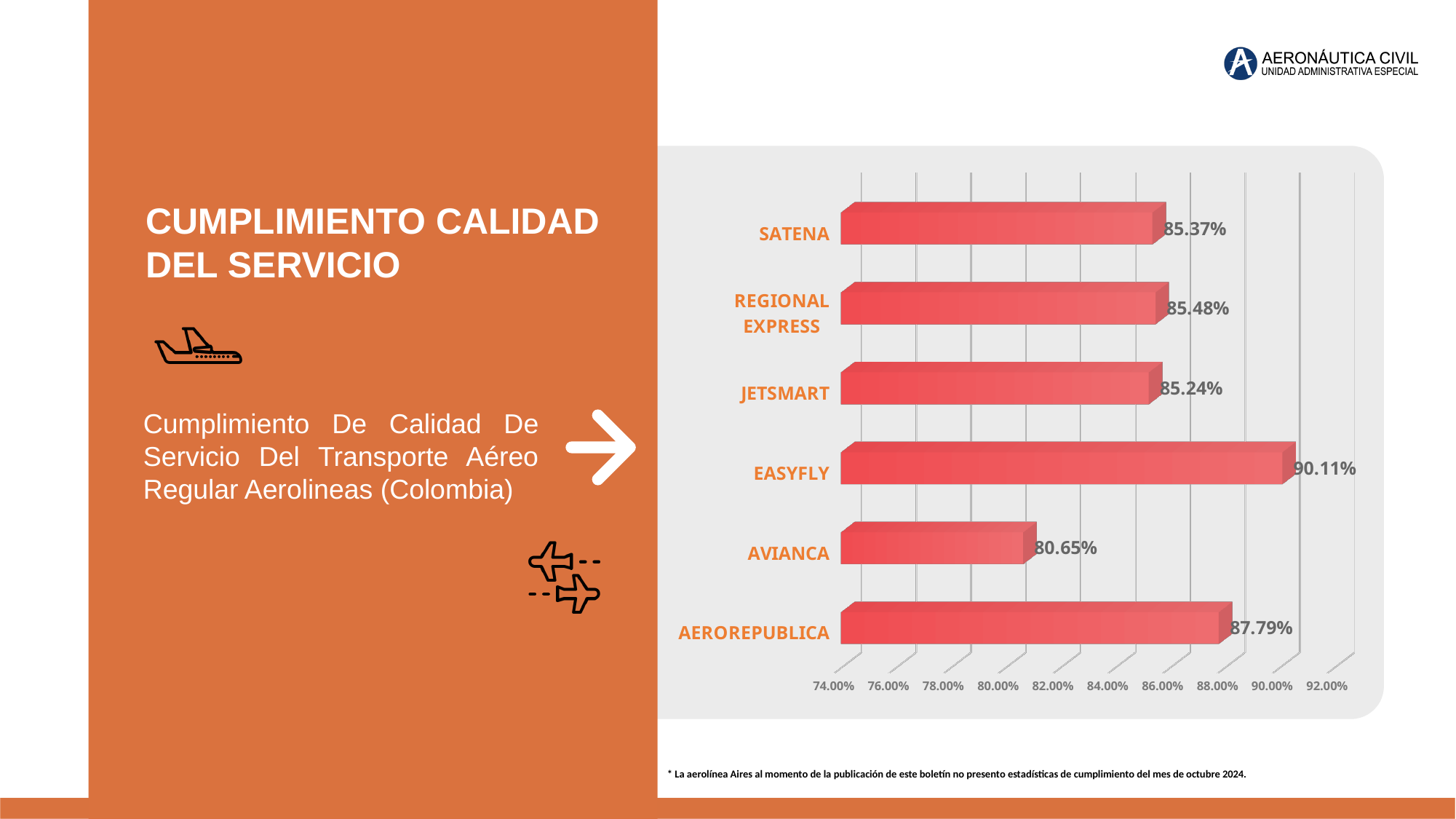
What is the difference between the values for EASYFLY and AVIANCA? 9.46% Is the value for AVIANCA greater or less than 82.00%? less Which airline has the lowest value? AVIANCA How many airlines are shown in the chart? 6 What is the value for AEROREPUBLICA? 87.79% What is the value for AVIANCA? 80.65% What is the value for SATENA? 85.37% What is the value for EASYFLY? 90.11% What is the value for REGIONAL EXPRESS? 85.48% What kind of chart is shown on the slide? bar chart Which airline has the highest value? EASYFLY Which is larger, the value for AEROREPUBLICA or the value for JETSMART? AEROREPUBLICA